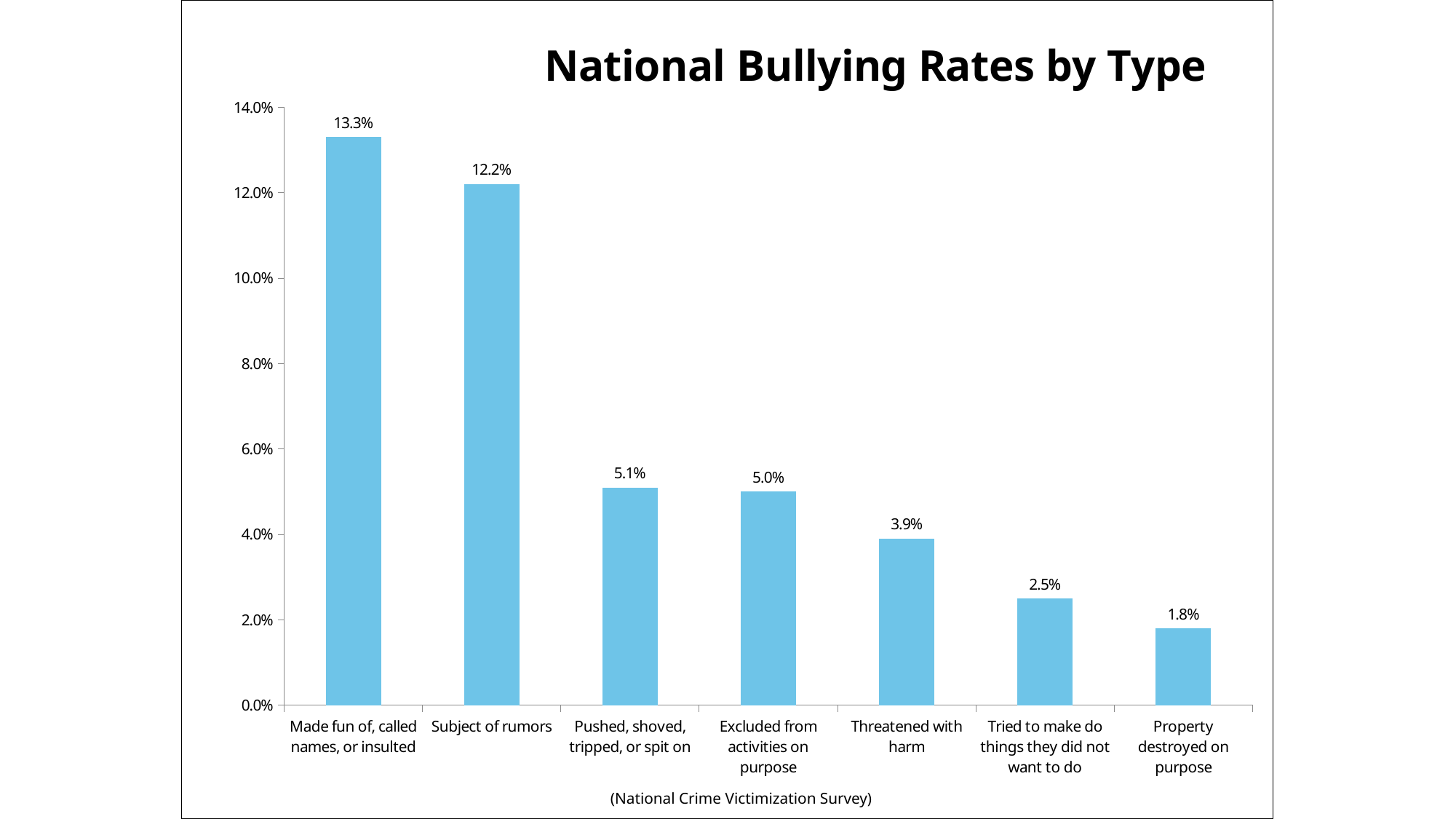
What kind of chart is shown on the slide? Bar chart What is the national bullying rate for "Subject of rumors"? 12.2% What is the difference between the rates for "Threatened with harm" and "Tried to make do things they did not want to do"? 1.4% What is the rate for "Property destroyed on purpose"? 1.8% What is the difference between the rates for "Made fun of, called names, or insulted" and "Subject of rumors"? 1.1% What is the rate for "Threatened with harm"? 3.9% Which bullying type has the lowest rate? Property destroyed on purpose Which is larger, the rate for "Pushed, shoved, tripped, or spit on" or the rate for "Threatened with harm"? Pushed, shoved, tripped, or spit on How many bullying types are shown in the chart? 7 Which bullying type has the highest rate? Made fun of, called names, or insulted Is the rate for "Excluded from activities on purpose" greater or less than 6.0%? less What is the title of the chart? National Bullying Rates by Type